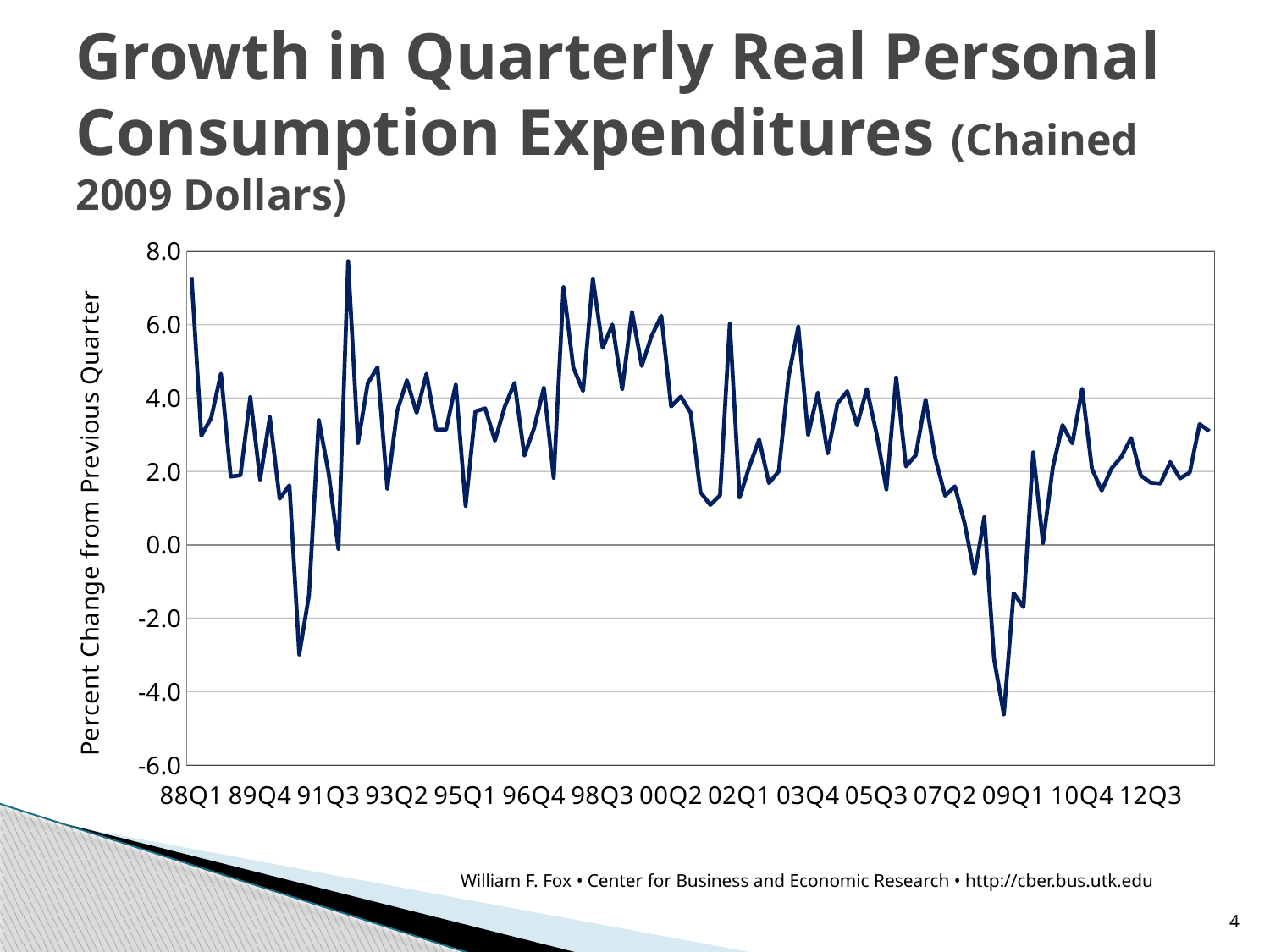
Is the lowest point on the line greater or less than -4.0? less Is the value for 09Q1 greater or less than 0.0? less What kind of chart is shown on the slide? line chart What is the highest value shown on the y axis? 8.0 Is the value for 88Q1 greater or less than 6.0? greater How many quarter labels are printed along the x axis? 15 What is the label on the vertical axis of the chart? Percent Change from Previous Quarter Near which x-axis label does the line reach its lowest value? 09Q1 What is the first quarter label shown on the x axis? 88Q1